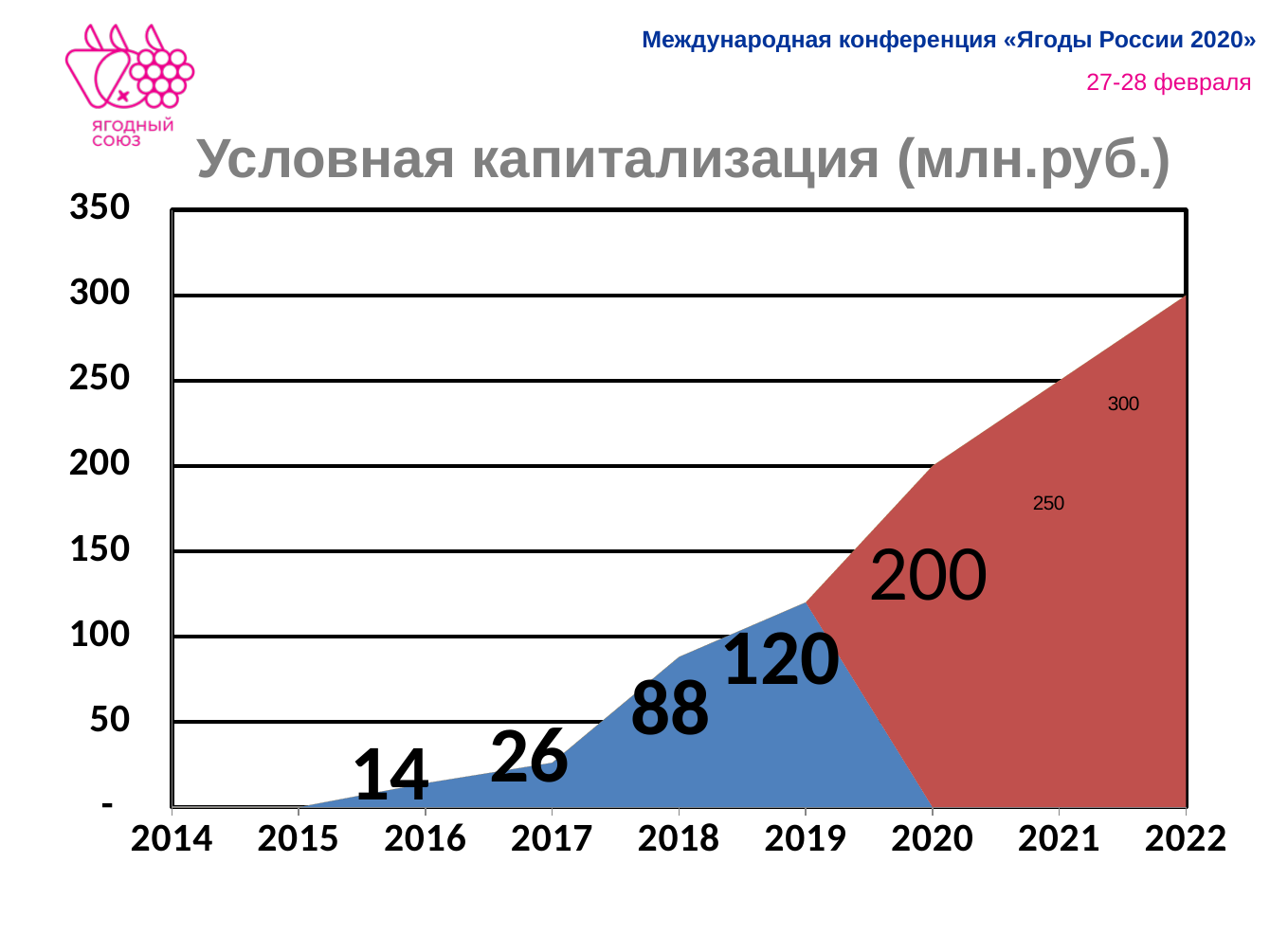
What is the value for 2020? 200 What is the difference between the values for 2019 and 2018? 32 Do the values rise or fall from 2015 to 2022? rise How many years are labelled on the x axis? 9 What is the value for 2018? 88 What is the title of the chart? Условная капитализация (млн.руб.) Which year has the highest value? 2022 What is the value for 2022? 300 What is the difference between the values for 2022 and 2021? 50 What is the value for 2016? 14 What type of chart is shown on the slide? area chart Which is larger, the value for 2017 or the value for 2019? 2019